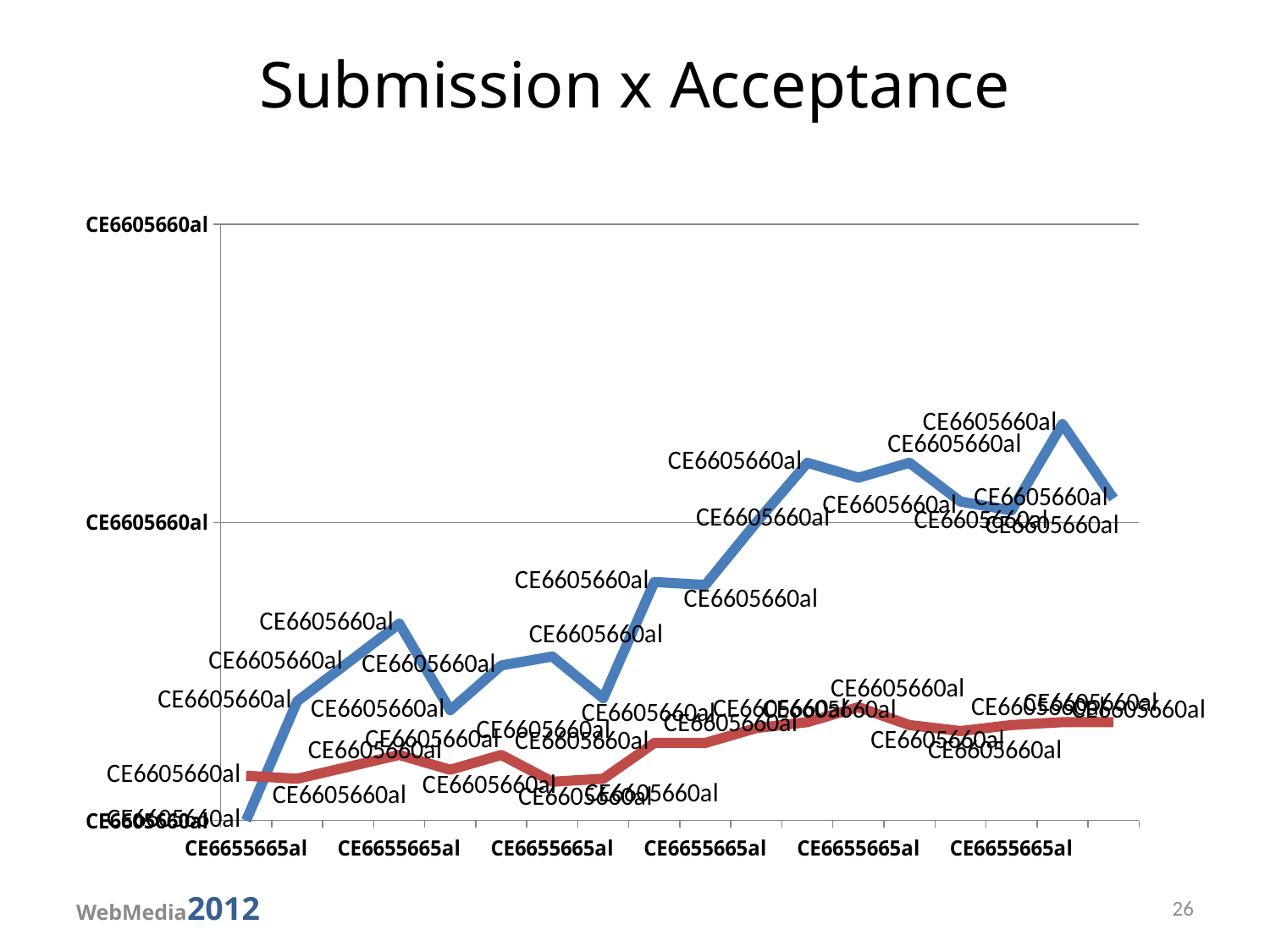
Does the red line generally rise or fall from left to right? rise What kind of chart is shown on the slide? line chart At the right end of the chart, which line is higher, the blue line or the red line? blue Does the blue line generally rise or fall from left to right? rise How many lines are plotted on the chart? 2 What is the title of the chart? Submission x Acceptance What colours are the two lines on the chart? blue and red